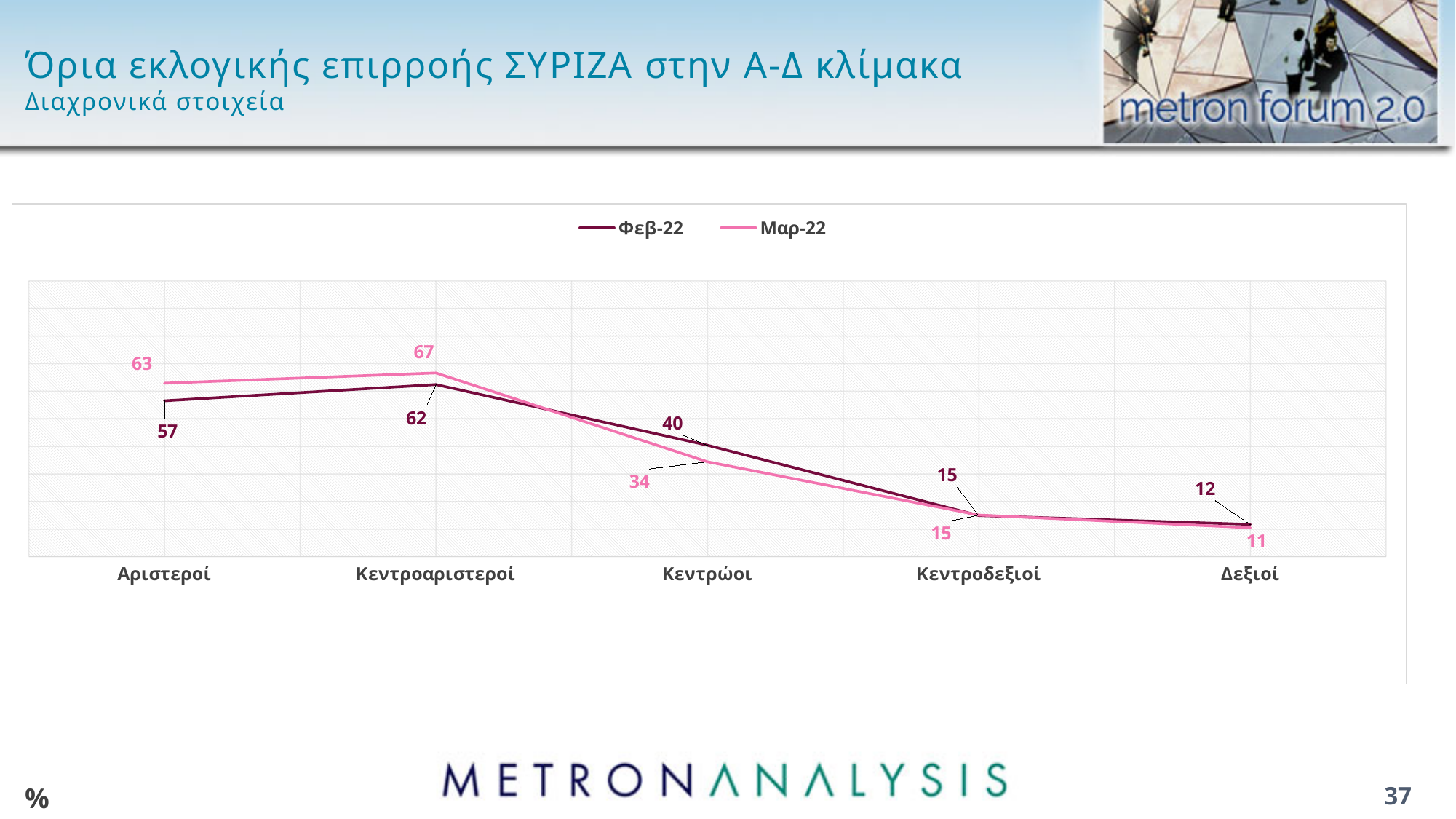
What is the value for Δεξιοί in the Μαρ-22 series? 11 How many categories are shown on the x axis? 5 What is the value for Αριστεροί in the Μαρ-22 series? 63 What is the difference between the Φεβ-22 and Μαρ-22 values for Κεντρώοι? 6 Which category has the lowest value in the Φεβ-22 series? Δεξιοί Which category has the highest value in the Μαρ-22 series? Κεντροαριστεροί Which series has the larger value for Κεντροαριστεροί, Φεβ-22 or Μαρ-22? Μαρ-22 What kind of chart is shown on the slide? line chart How many series does the legend list? 2 What is the value for Κεντρώοι in the Φεβ-22 series? 40 What is the difference between the Μαρ-22 and Φεβ-22 values for Αριστεροί? 6 Do the Μαρ-22 values rise or fall from Κεντροαριστεροί to Δεξιοί? fall